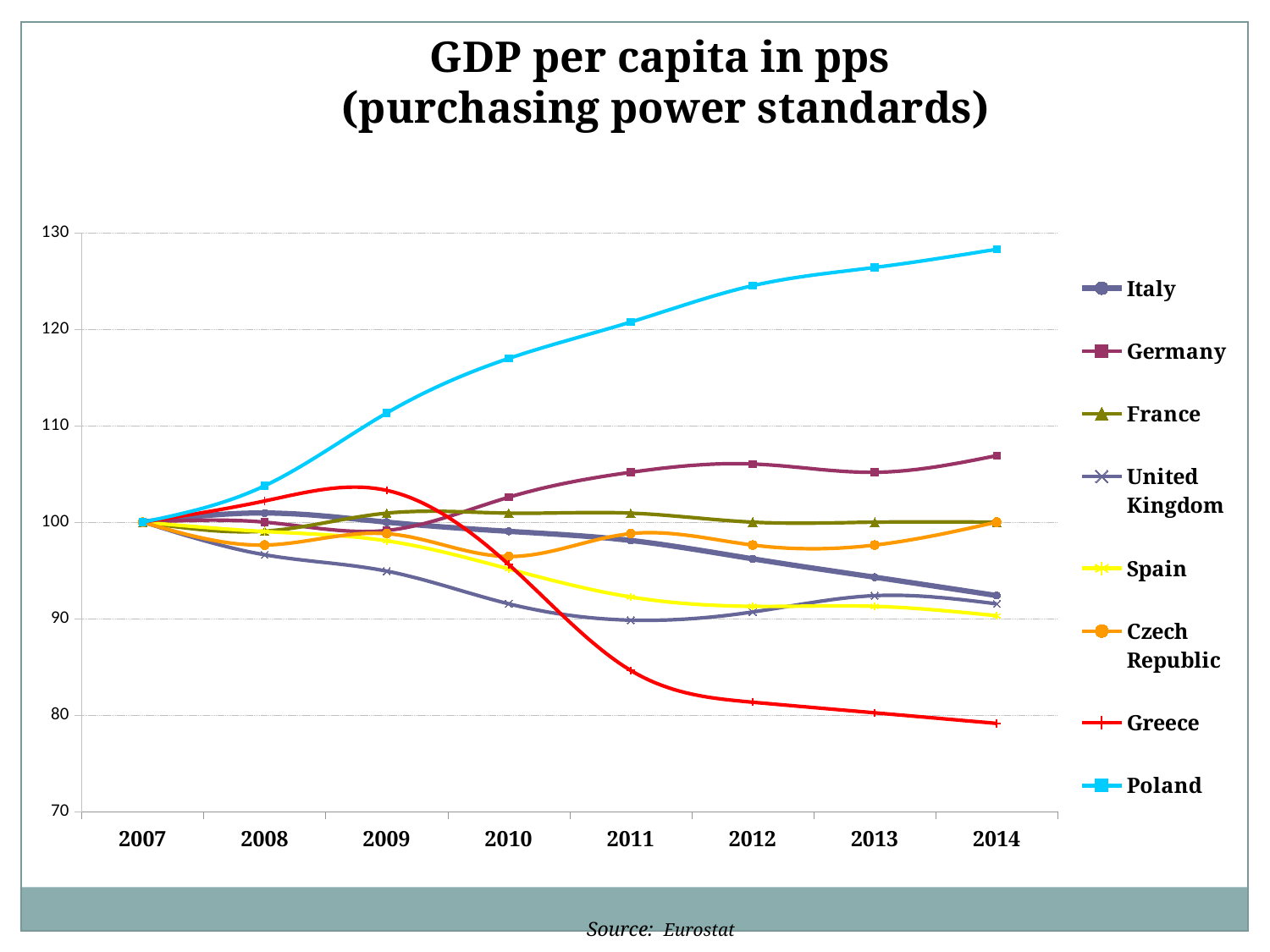
Which country has the highest GDP per capita in pps in 2014? Poland What is the value for Italy in 2007? 100 In 2014, which is larger: the value for Germany or the value for France? Germany Which country has the lowest GDP per capita in pps in 2014? Greece What kind of chart is shown on the slide? line chart Is the value for Poland in 2014 greater or less than 120? greater How many series does the legend list? 8 Is the value for Greece in 2014 greater or less than 80? less Does the value for Poland rise or fall from 2007 to 2014? rise How many years are shown along the x axis? 8 Is the value for Czech Republic in 2010 greater or less than 100? less Does the value for Greece rise or fall from 2009 to 2014? fall